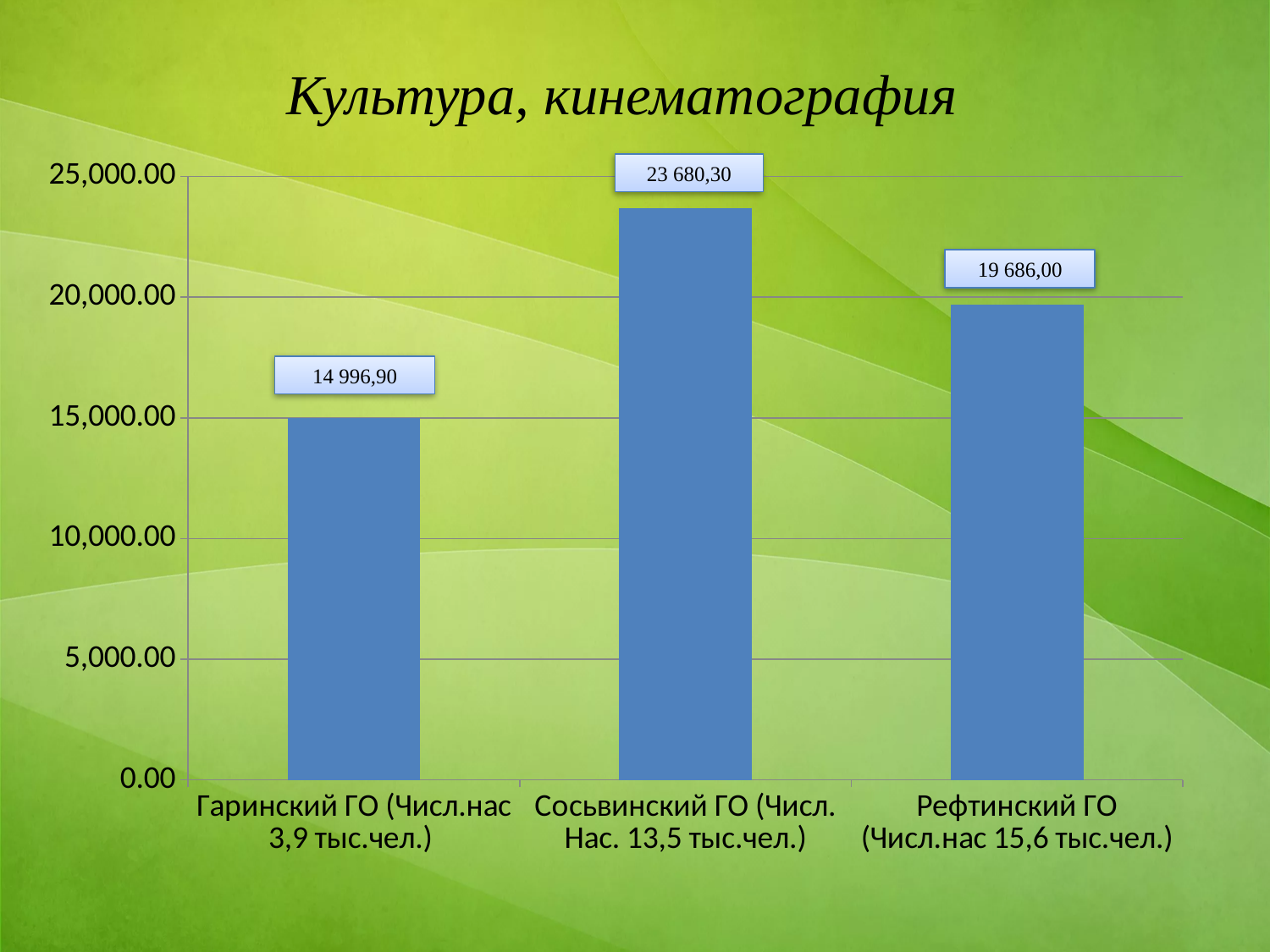
What kind of chart is shown on the slide? bar chart How many categories are shown in the chart? 3 What is the difference between the values for Сосьвинский ГО and Гаринский ГО? 8 683,40 Which category has the highest value? Сосьвинский ГО What is the value for Сосьвинский ГО? 23 680,30 Which is larger, the value for Рефтинский ГО or the value for Гаринский ГО? Рефтинский ГО What is the title of the slide? Культура, кинематография What is the value for Гаринский ГО? 14 996,90 What is the difference between the values for Сосьвинский ГО and Рефтинский ГО? 3 994,30 Which category has the lowest value? Гаринский ГО What is the value for Рефтинский ГО? 19 686,00 Is the value for Рефтинский ГО greater or less than 20,000.00? less